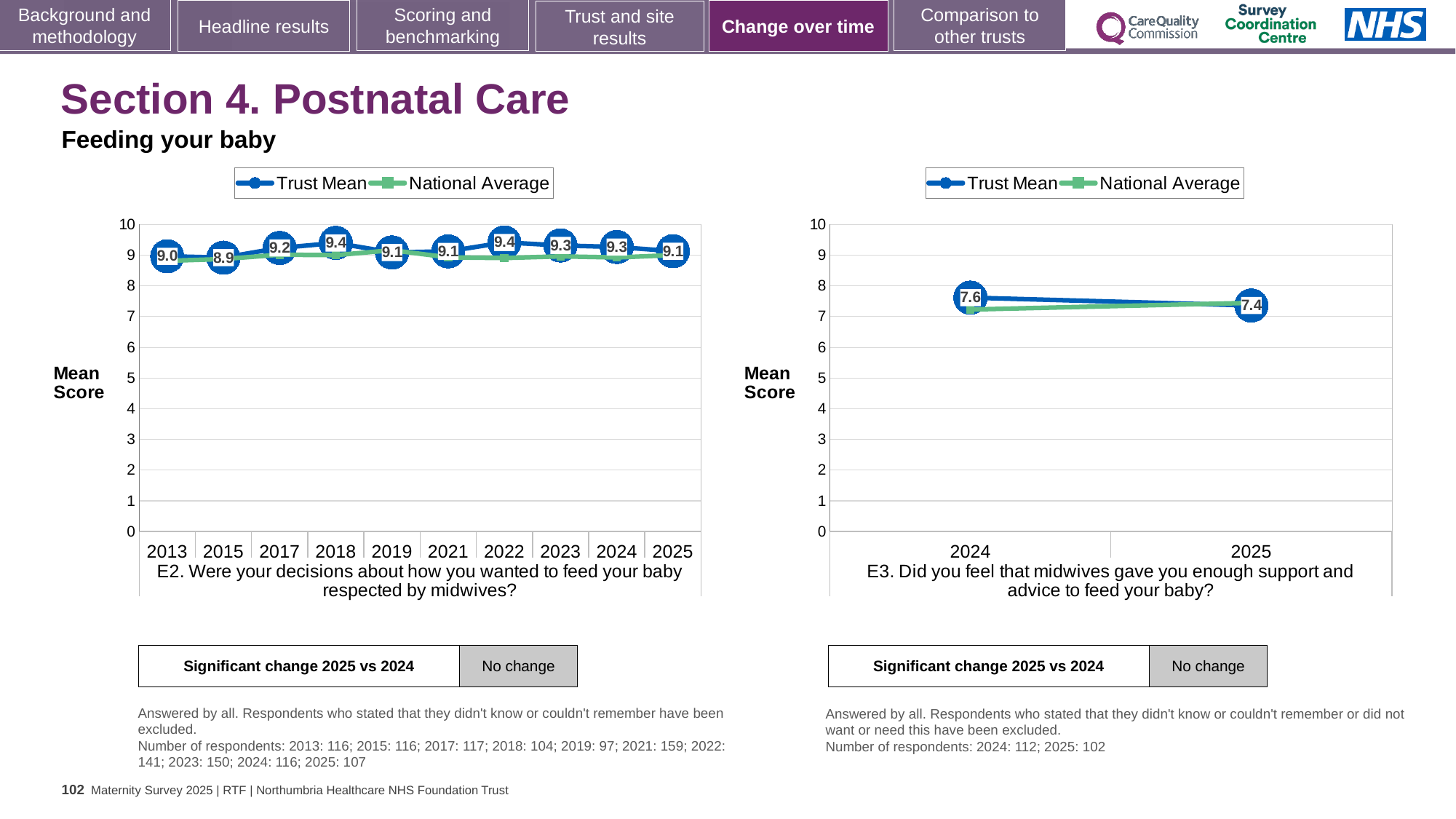
In the E2 chart on the left, what is the Trust Mean for 2025? 9.1 In the E3 chart on the right, what is the Trust Mean for 2024? 7.6 In the E3 chart on the right, does the Trust Mean rise or fall from 2024 to 2025? fall In the E3 chart on the right, is the National Average for 2024 greater or less than 8? less In the E2 chart on the left, what is the difference between the Trust Mean for 2018 and for 2015? 0.5 In the E2 chart on the left, what is the Trust Mean for 2018? 9.4 In the E2 chart on the left, is the Trust Mean higher in 2023 or in 2025? 2023 How many series does the legend of the E2 chart on the left list? 2 In the E2 chart on the left, which year has the lowest Trust Mean? 2015 In the E3 chart on the right, what is the Trust Mean for 2025? 7.4 In the E3 chart on the right, what is the difference between the Trust Mean for 2024 and for 2025? 0.2 In the E2 chart on the left, how many years are plotted on the x axis? 10